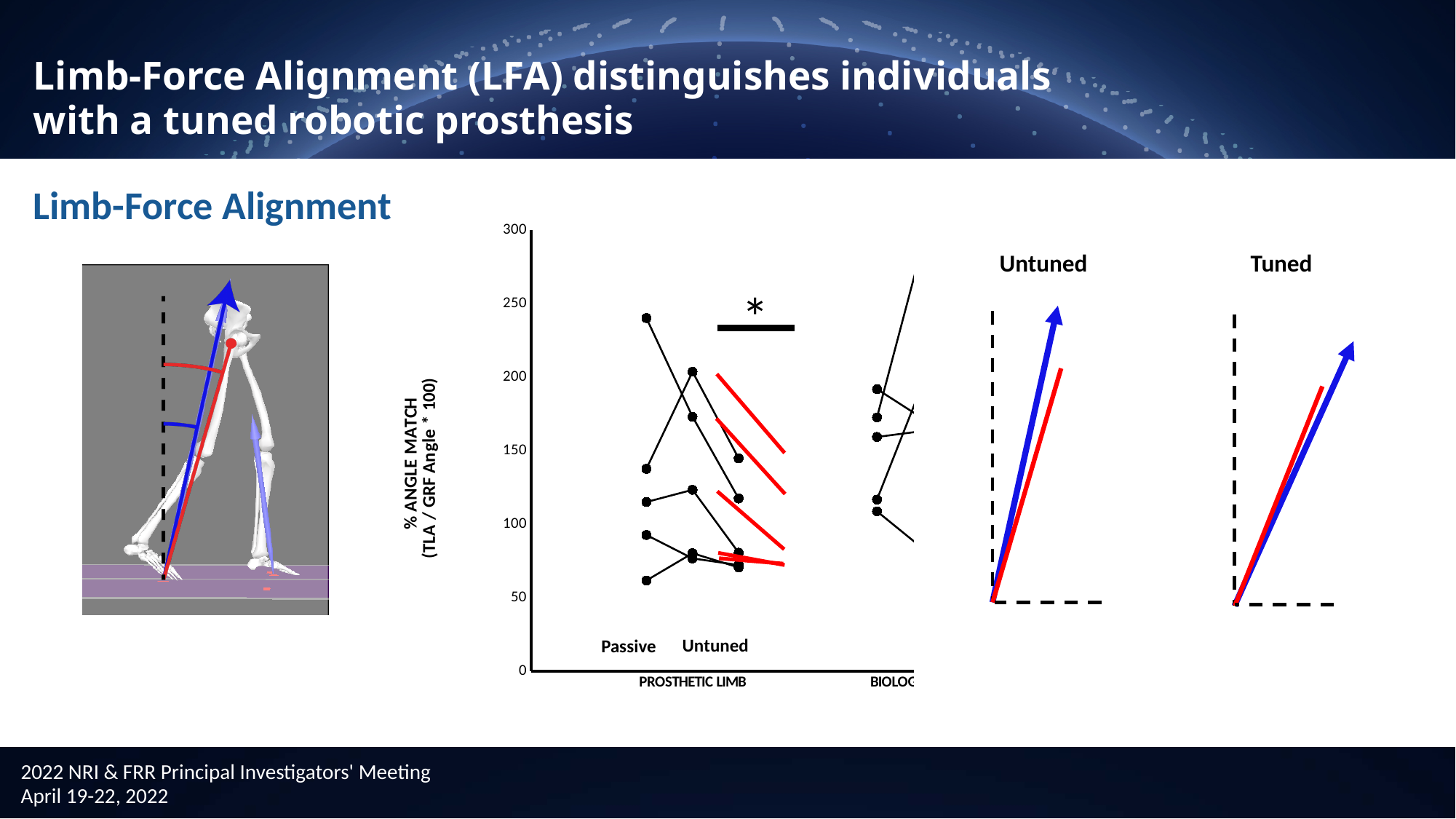
Do the red lines starting at the Untuned column slope upward or downward toward the column to the right? downward How many data points are plotted in the Passive column? 5 Is the lowest Passive value greater or less than 100? less What kind of chart is shown in the middle of the slide? line chart What symbol is shown above the horizontal bar between the Untuned column and the column to its right? * Is the lowest Untuned value greater or less than 100? less Is the highest Untuned value greater or less than 150? greater Which column has the higher maximum value, Passive or Untuned? Passive What is the label on the y-axis of the chart? % ANGLE MATCH (TLA / GRF Angle * 100) How many tick labels are shown on the y-axis of the chart? 7